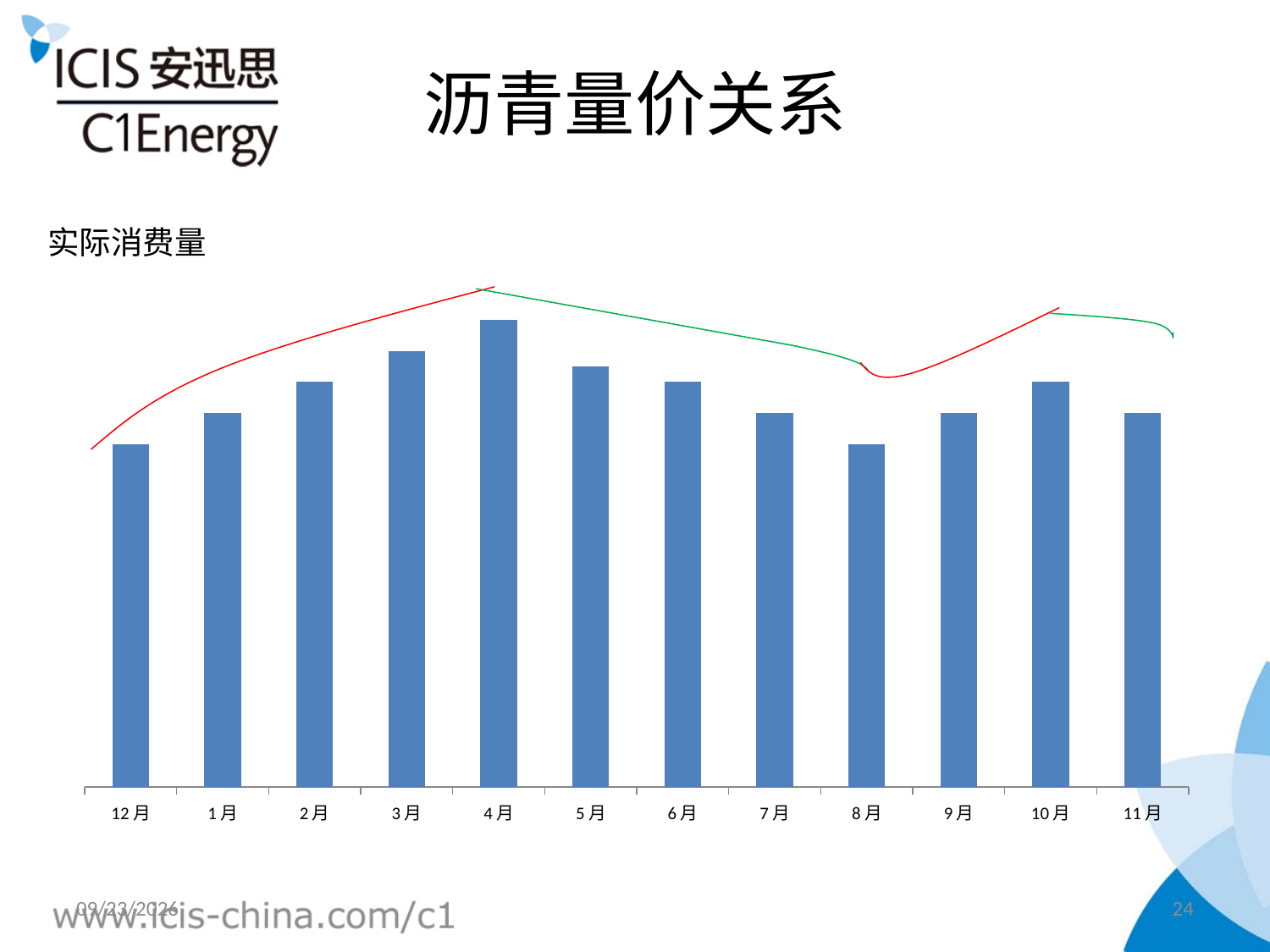
Do the bars rise or fall from 12月 to 4月? rise What kind of chart is shown on the slide? bar chart Do the bars rise or fall from 4月 to 8月? fall What is the title of the slide? 沥青量价关系 How many months are shown on the x axis of the chart? 12 Which month has the highest bar in the chart? 4月 Which month is the first category on the x axis? 12月 Which is larger, the value for 3月 or the value for 1月? 3月 Which is larger, the value for 4月 or the value for 8月? 4月 Which is larger, the value for 10月 or the value for 9月? 10月 What label appears above the chart describing the plotted quantity? 实际消费量